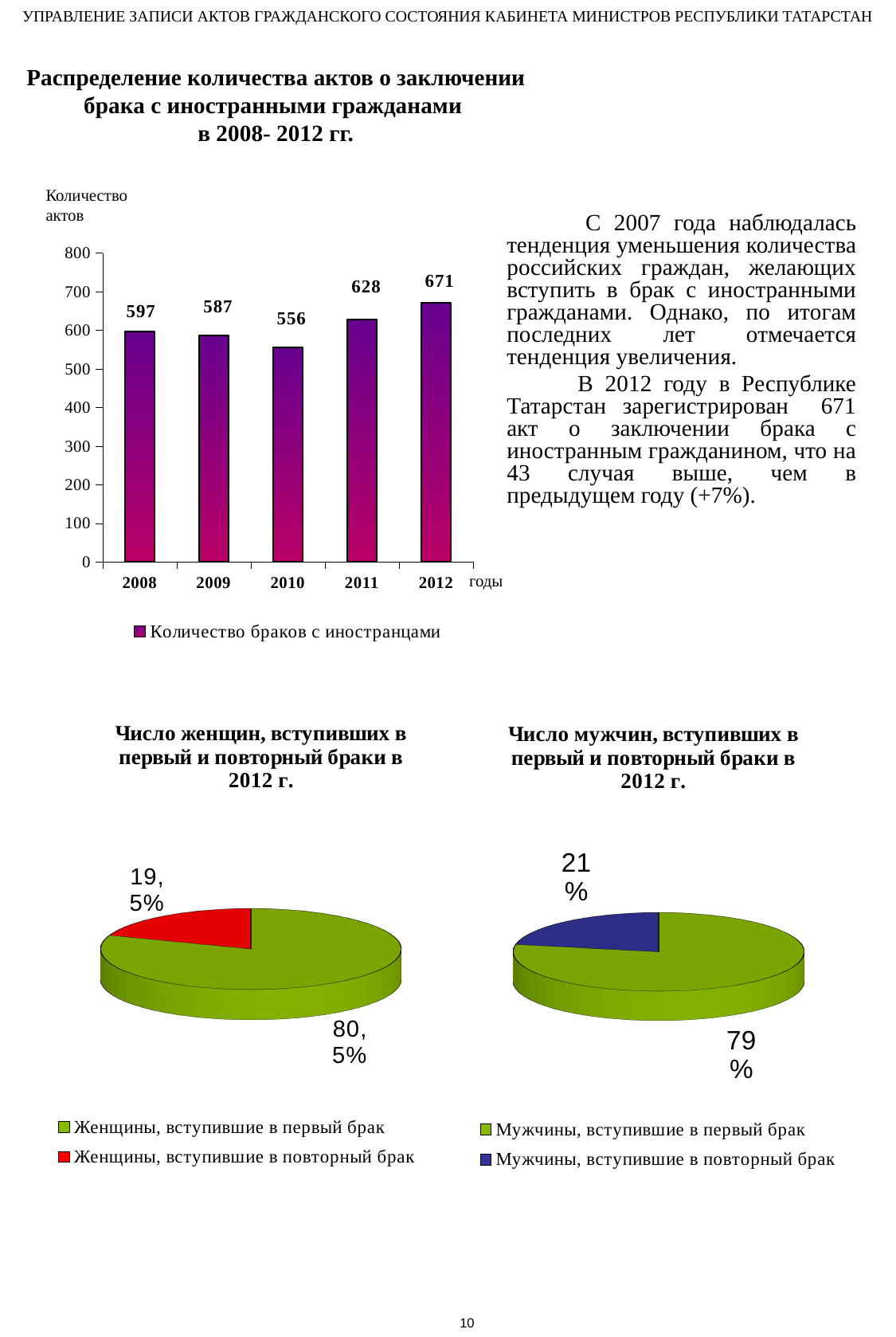
In the bar chart 'Распределение количества актов о заключении брака с иностранными гражданами в 2008- 2012 гг.', do the values rise or fall from 2010 to 2012? rise What type of chart is the top chart 'Распределение количества актов о заключении брака с иностранными гражданами в 2008- 2012 гг.'? bar chart In the bar chart 'Распределение количества актов о заключении брака с иностранными гражданами в 2008- 2012 гг.', which year has the highest value? 2012 In the bar chart 'Распределение количества актов о заключении брака с иностранными гражданами в 2008- 2012 гг.', which year has the lowest value? 2010 In the pie chart 'Число мужчин, вступивших в первый и повторный браки в 2012 г.', what share is shown for 'Мужчины, вступившие в первый брак'? 79% In the pie chart 'Число женщин, вступивших в первый и повторный браки в 2012 г.', what share is shown for 'Женщины, вступившие в повторный брак'? 19,5% In the bar chart 'Распределение количества актов о заключении брака с иностранными гражданами в 2008- 2012 гг.', what is the difference between the values for 2012 and 2011? 43 In the bar chart 'Распределение количества актов о заключении брака с иностранными гражданами в 2008- 2012 гг.', how many years are shown on the x axis? 5 In the bar chart 'Распределение количества актов о заключении брака с иностранными гражданами в 2008- 2012 гг.', which is larger, the value for 2008 or the value for 2009? 2008 In the pie chart 'Число мужчин, вступивших в первый и повторный браки в 2012 г.', how many entries does the legend list? 2 In the bar chart 'Распределение количества актов о заключении брака с иностранными гражданами в 2008- 2012 гг.', what is the value for 2012? 671 In the bar chart 'Распределение количества актов о заключении брака с иностранными гражданами в 2008- 2012 гг.', what is the value for 2010? 556